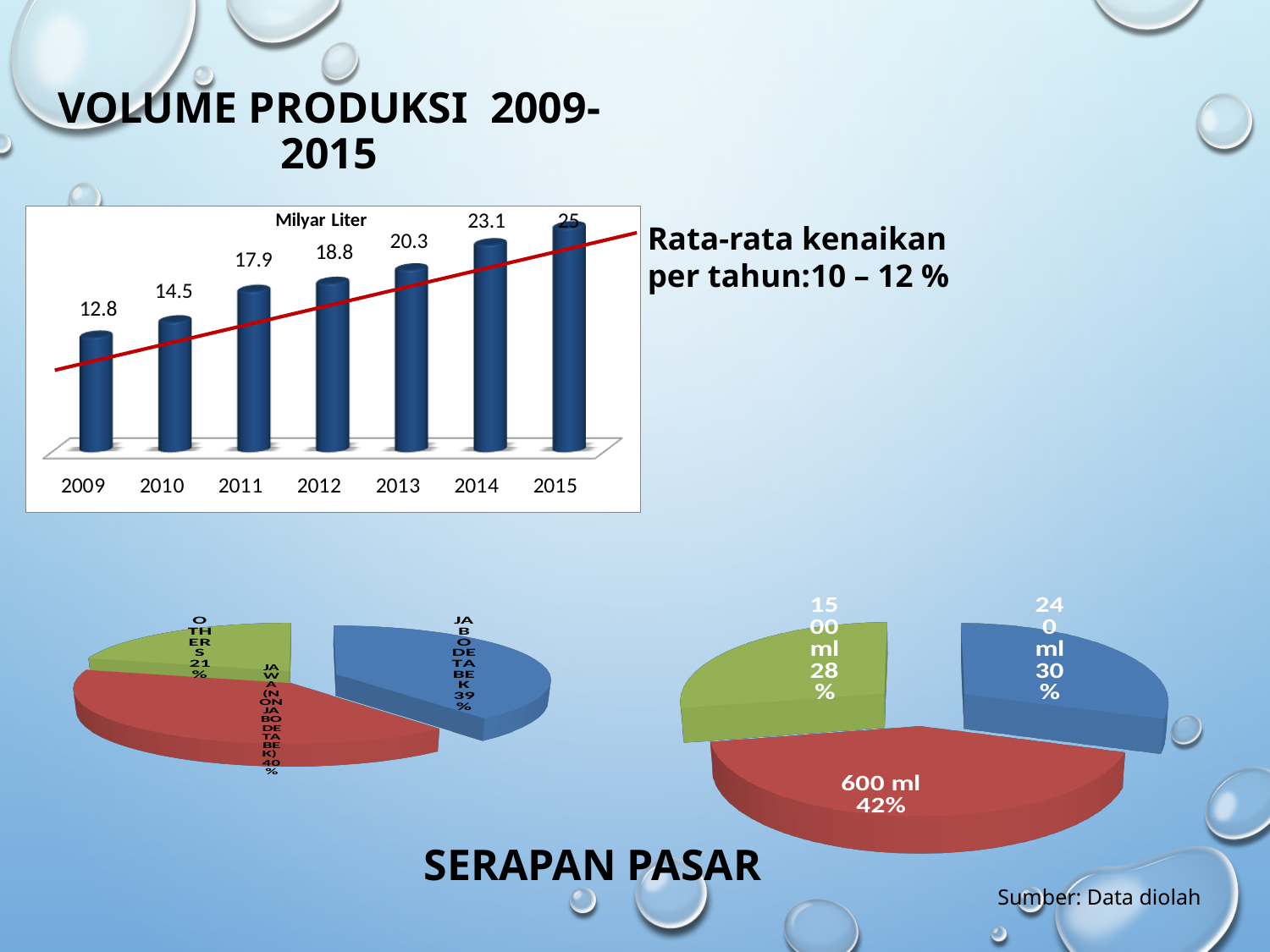
In the pie chart at the bottom right, what share does the 600 ml slice have? 42% In the bar chart 'Volume Produksi 2009-2015', how many years are shown on the x axis? 7 In the bar chart 'Volume Produksi 2009-2015', which year has the highest value? 2015 In the bar chart 'Volume Produksi 2009-2015', which year has the lowest value? 2009 In the bar chart 'Volume Produksi 2009-2015', what is the difference between the values for 2015 and 2009? 12.2 In the bar chart 'Volume Produksi 2009-2015', what is the value for 2009? 12.8 In the pie chart at the bottom left, what share does the OTHERS slice have? 21% In the pie chart at the bottom right, which slice is the smallest? 1500 ml In the bar chart 'Volume Produksi 2009-2015', what unit is shown above the bars? Milyar Liter In the bar chart 'Volume Produksi 2009-2015', do the values rise or fall from 2009 to 2015? rise In the bar chart 'Volume Produksi 2009-2015', what is the value for 2013? 20.3 What kind of chart is the 'Volume Produksi 2009-2015' chart? bar chart